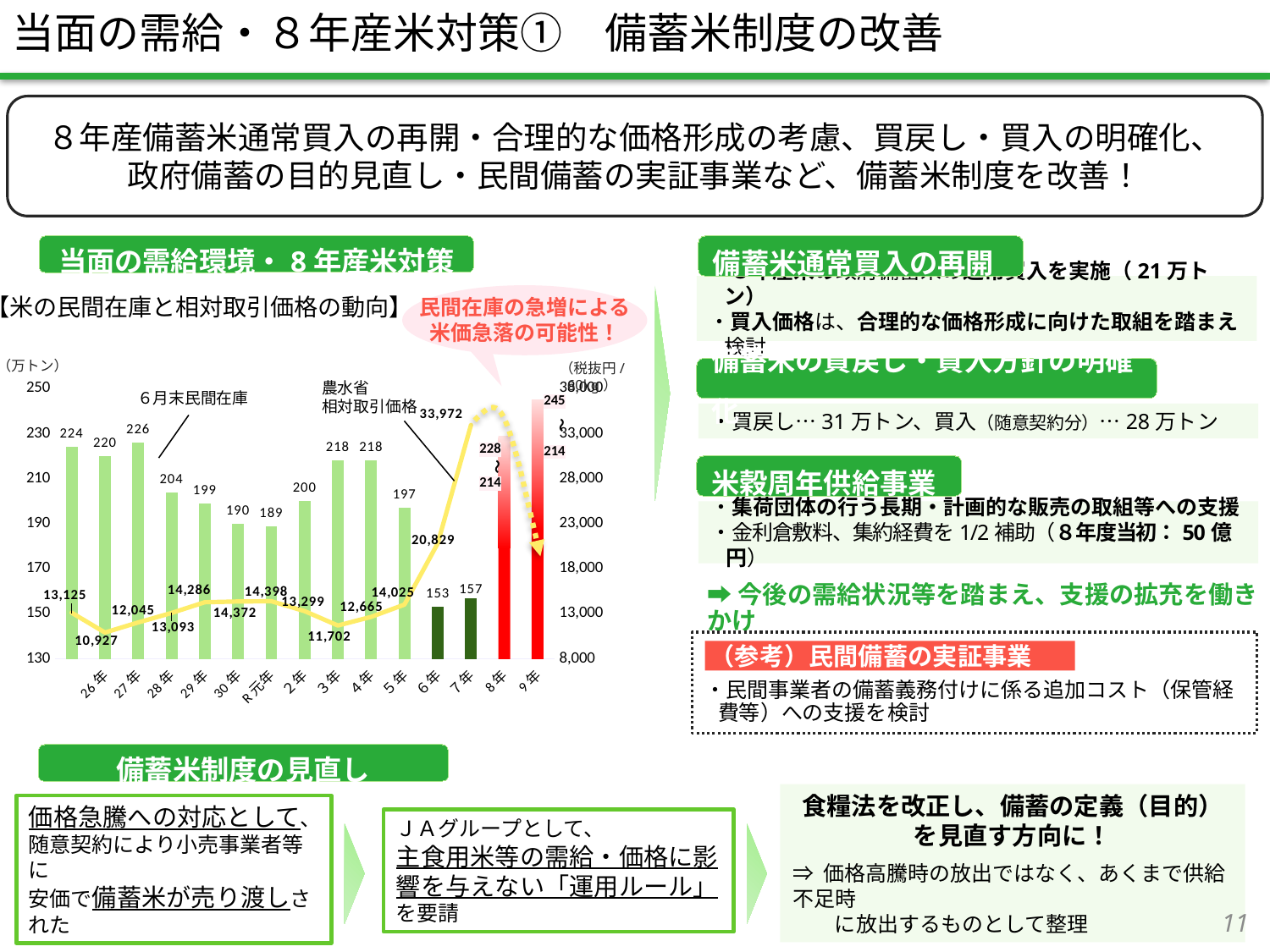
In the 【米の民間在庫と相対取引価格の動向】 chart, what is the highest labelled value on the 農水省相対取引価格 line? 33,972 In the 【米の民間在庫と相対取引価格の動向】 chart, what is the difference between the 6月末民間在庫 values for 7年 (157) and 6年 (153)? 4 In the 【米の民間在庫と相対取引価格の動向】 chart, what is the lowest labelled value on the 農水省相対取引価格 line? 10,927 In the 【米の民間在庫と相対取引価格の動向】 chart, what is the 6月末民間在庫 value for 7年? 157 In the 【米の民間在庫と相対取引価格の動向】 chart, what is the difference between the highest (226) and lowest (153) labelled 6月末民間在庫 bar values? 73 In the 【米の民間在庫と相対取引価格の動向】 chart, what is the lowest tick value shown on the right vertical axis? 8,000 In the 【米の民間在庫と相対取引価格の動向】 chart, which is larger, the 6月末民間在庫 value for 7年 or for 6年? 7年 In the 【米の民間在庫と相対取引価格の動向】 chart, what is the highest labelled value among the 6月末民間在庫 bars? 245 In the 【米の民間在庫と相対取引価格の動向】 chart, what is the 6月末民間在庫 value for 6年? 153 What kind of chart is used in the 【米の民間在庫と相対取引価格の動向】 chart? A combined bar and line chart In the 【米の民間在庫と相対取引価格の動向】 chart, what is the lowest labelled value among the 6月末民間在庫 bars? 153 In the 【米の民間在庫と相対取引価格の動向】 chart, what unit is shown on the left vertical axis? 万トン